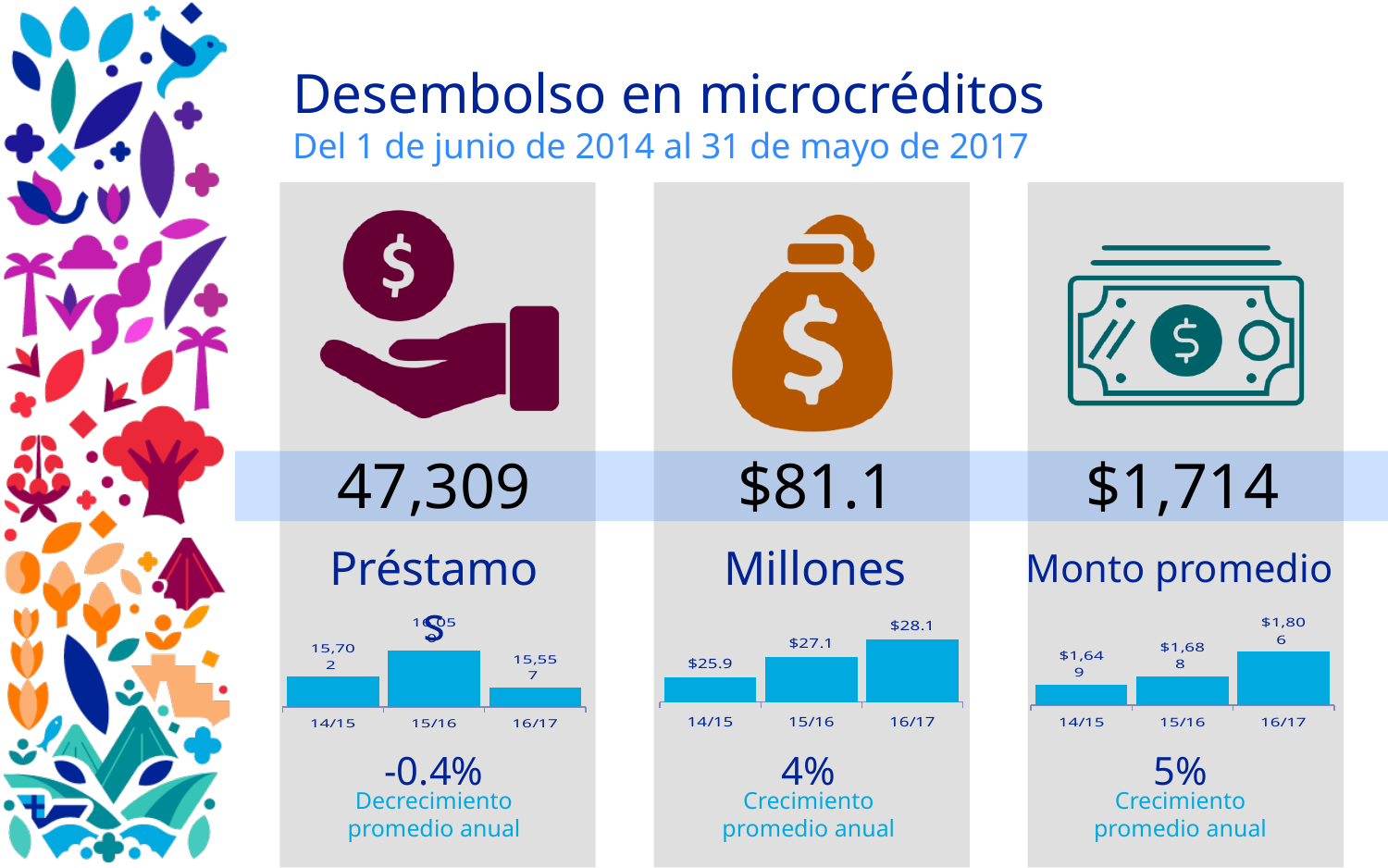
In the 'Millones' chart (middle), what is the value for 14/15? $25.9 In the 'Monto promedio' chart (right), which period has the highest value? 16/17 In the 'Millones' chart (middle), what is the difference between the 16/17 and 14/15 values? $2.2 What kind of chart is the 'Monto promedio' chart (right)? Bar chart How many periods are shown in the 'Millones' chart (middle)? 3 In the 'Millones' chart (middle), do the values rise or fall from 14/15 to 16/17? Rise In the 'Monto promedio' chart (right), what is the value for 15/16? $1,688 In the 'Monto promedio' chart (right), what is the difference between the 16/17 and 14/15 values? $157 In the 'Préstamo' chart (left), which period has the lowest value? 16/17 In the 'Préstamo' chart (left), what is the value for 14/15? 15,702 In the 'Millones' chart (middle), what is the value for 16/17? $28.1 In the 'Préstamo' chart (left), which is larger, the value for 14/15 or the value for 16/17? 14/15